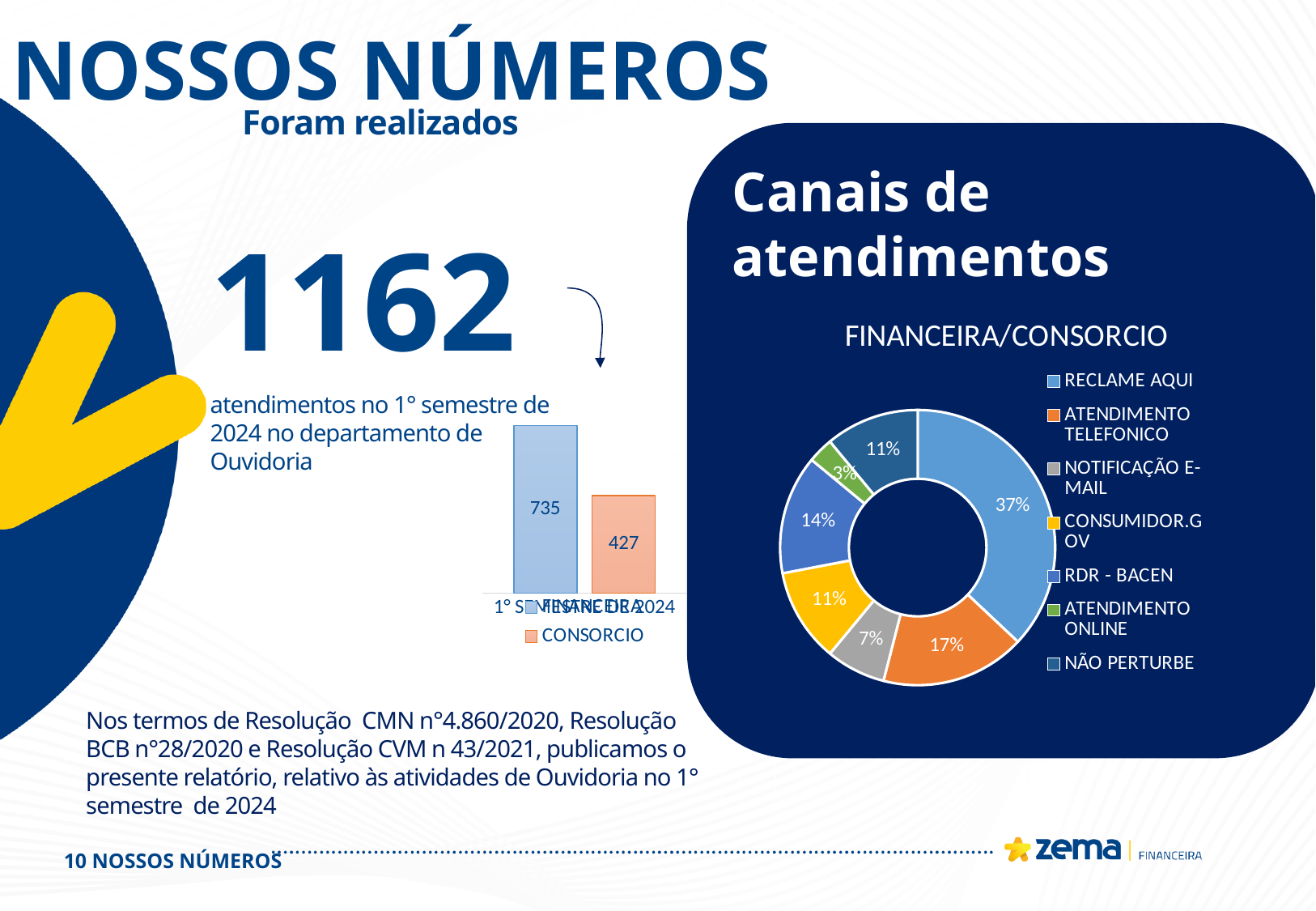
What kind of chart is the FINANCEIRA/CONSORCIO chart? Doughnut chart In the bar chart, what is the value of the taller (blue) bar? 735 What kind of chart is the chart on the left showing 735 and 427? Bar chart In the bar chart, what is the value for CONSORCIO? 427 In the FINANCEIRA/CONSORCIO chart, what share does RECLAME AQUI have? 37% In the FINANCEIRA/CONSORCIO chart, which channel has the smallest share? ATENDIMENTO ONLINE In the bar chart, which series has the larger value, FINANCEIRA or CONSORCIO? FINANCEIRA In the bar chart, what is the difference between the two bars (735 and 427)? 308 In the FINANCEIRA/CONSORCIO chart, what share does RDR - BACEN have? 14% How many channels does the legend of the FINANCEIRA/CONSORCIO chart list? 7 In the FINANCEIRA/CONSORCIO chart, which channel has the largest share? RECLAME AQUI In the FINANCEIRA/CONSORCIO chart, what share does ATENDIMENTO TELEFONICO have? 17%